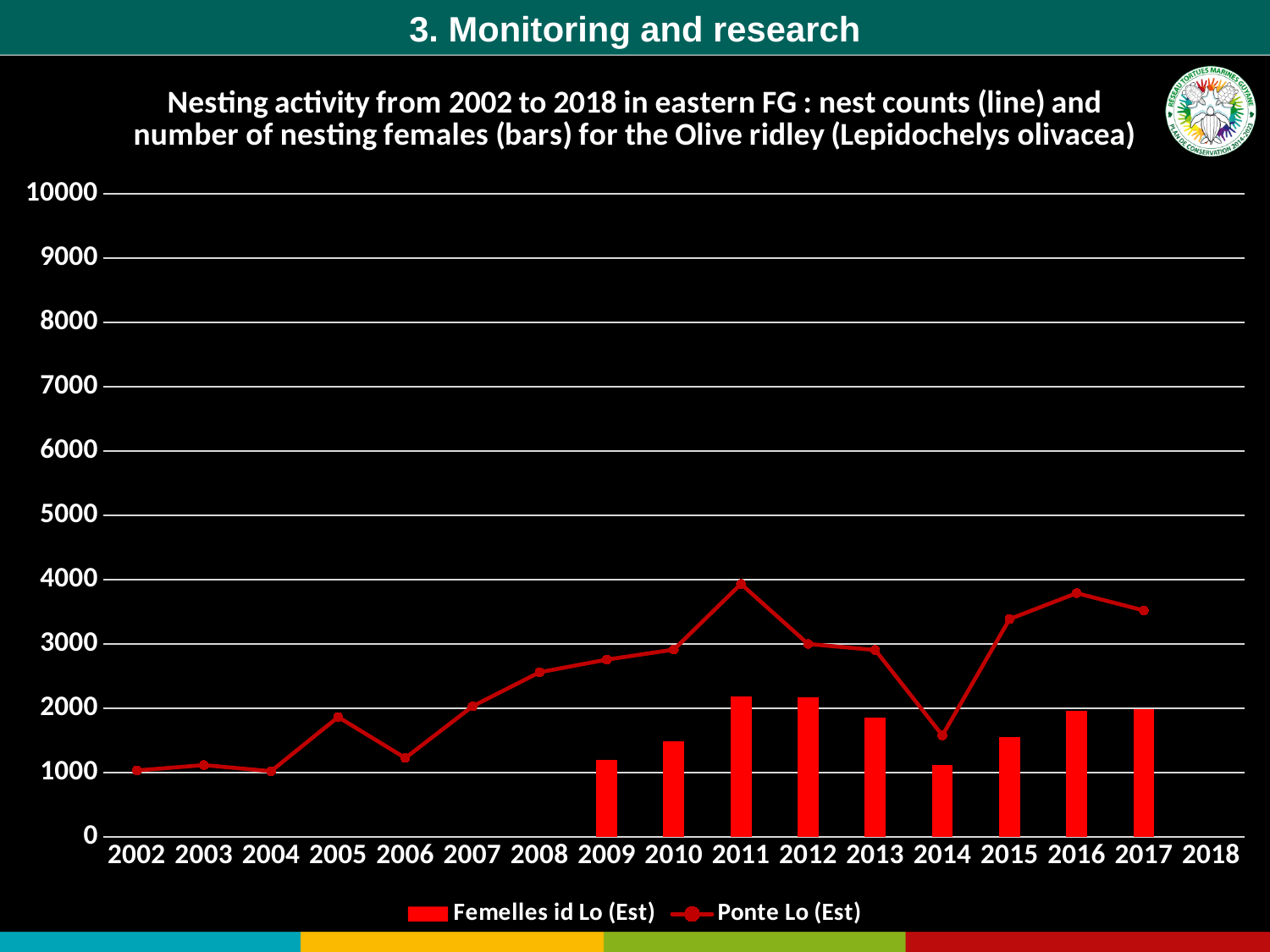
How many series does the legend list? 2 Is the Ponte Lo (Est) value for 2014 greater or less than 2000? less What kind of chart is shown on the slide? A combined bar and line chart Is the Femelles id Lo (Est) bar for 2011 greater or less than 2000? greater What is the first year for which a Femelles id Lo (Est) bar is shown? 2009 Is the Ponte Lo (Est) value for 2011 greater or less than 3000? greater In which year does the Ponte Lo (Est) line reach its highest value? 2011 Which year has the higher Ponte Lo (Est) value, 2005 or 2016? 2016 Does the Ponte Lo (Est) line generally rise or fall from 2002 to 2011? rise Which year has the taller Femelles id Lo (Est) bar, 2011 or 2014? 2011 How many years are labelled on the x axis? 17